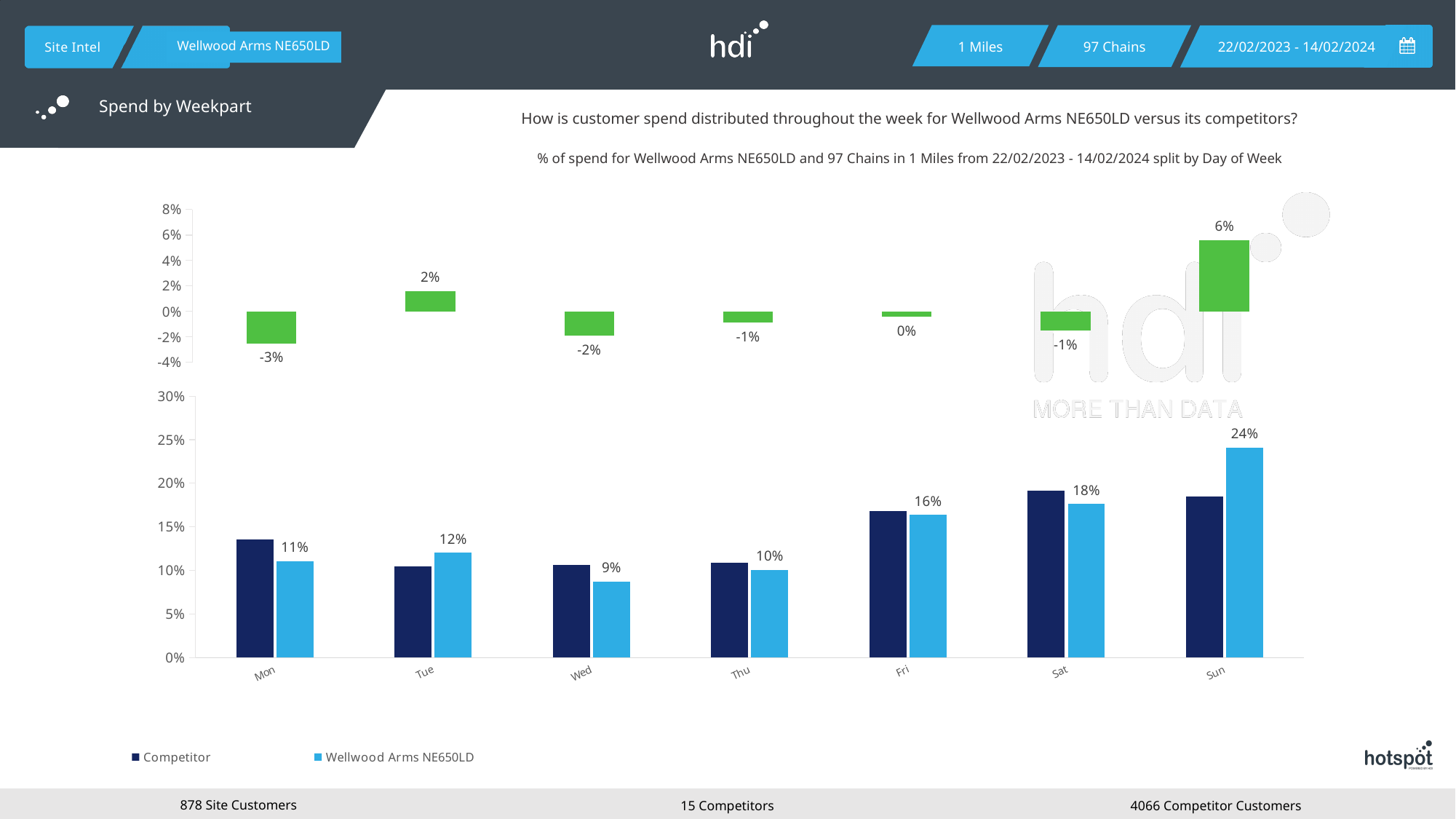
In the bottom chart, is the Competitor value for Sat greater or less than 15%? greater In the bottom chart, on Mon, which is larger: the Competitor bar or the Wellwood Arms NE650LD bar? Competitor In the bottom chart, on which day is the Wellwood Arms NE650LD value highest? Sun In the bottom chart, what is the value for Wellwood Arms NE650LD on Sun? 24% What are the two entries in the legend of the bottom chart? Competitor and Wellwood Arms NE650LD In the top chart, what is the value shown for Tue? 2% How many series does the legend of the bottom chart list? 2 In the bottom chart, what is the difference between the Wellwood Arms NE650LD values for Sun and Sat? 6% In the top chart, which day has the lowest value? Mon How many days of the week are shown on the x axis of the bottom chart? 7 What kind of chart is the bottom chart? bar chart In the bottom chart, on which day is the Wellwood Arms NE650LD value lowest? Wed